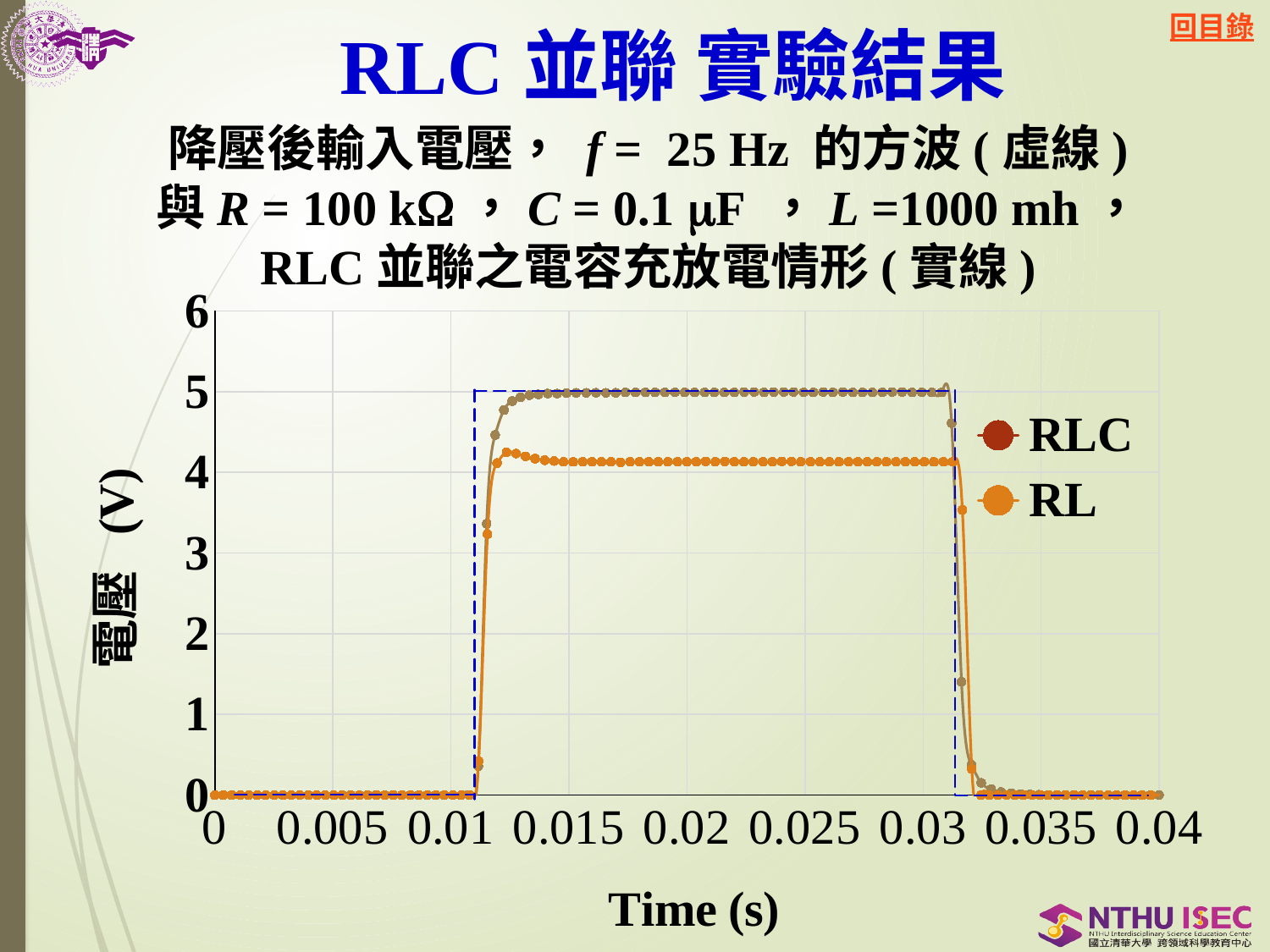
Between 0.03 s and 0.035 s, does the RLC voltage rise or fall? fall Is the voltage of the RL series at 0.02 s greater or less than 5 V? less Is the voltage of the RLC series at 0.02 s greater or less than 4 V? greater How many series does the chart legend list? 2 What is the label of the x axis of the chart? Time (s) What are the two series named in the chart legend? RLC and RL Between 0.01 s and 0.015 s, does the RL voltage rise or fall? rise What is the voltage of the RL series at a time of 0.035 s? 0 Is the voltage of the RL series at 0.02 s greater or less than 4 V? greater What is the voltage of the RLC series at a time of 0.005 s? 0 What kind of chart is shown on the slide? line chart